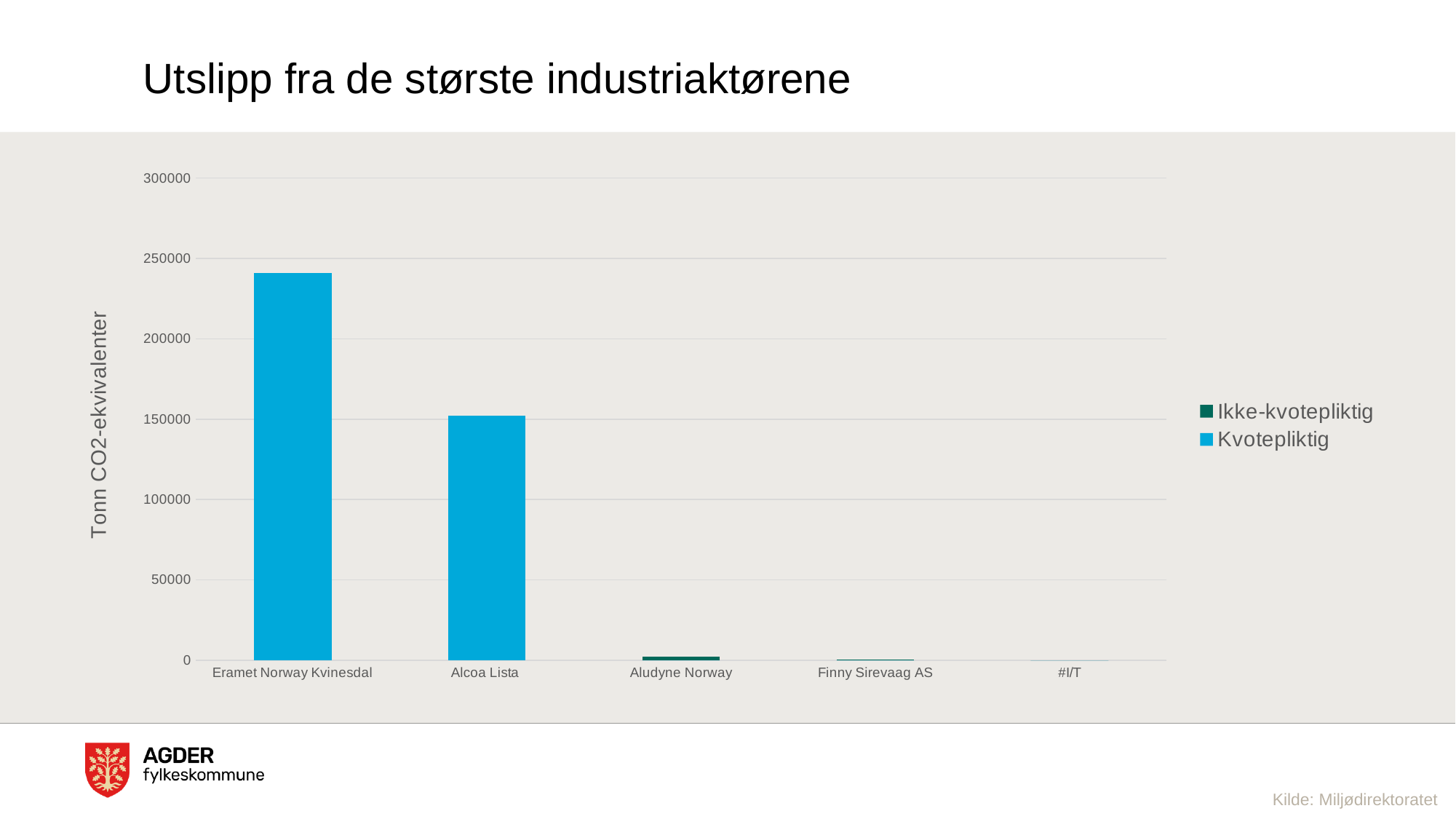
Is the value for Aludyne Norway greater or less than 50000? less How many series does the legend list? 2 Which is larger, the value for Eramet Norway Kvinesdal or the value for Alcoa Lista? Eramet Norway Kvinesdal How many categories are shown along the x axis? 5 What kind of chart is shown on the slide? bar chart What is the label on the y axis? Tonn CO2-ekvivalenter Is the value for Alcoa Lista greater or less than 200000? less What is the title of the chart? Utslipp fra de største industriaktørene Is the value for Eramet Norway Kvinesdal greater or less than 200000? greater Which is larger, the value for Alcoa Lista or the value for Aludyne Norway? Alcoa Lista Which category has the highest emissions? Eramet Norway Kvinesdal Do the values rise or fall from left to right along the x axis? fall